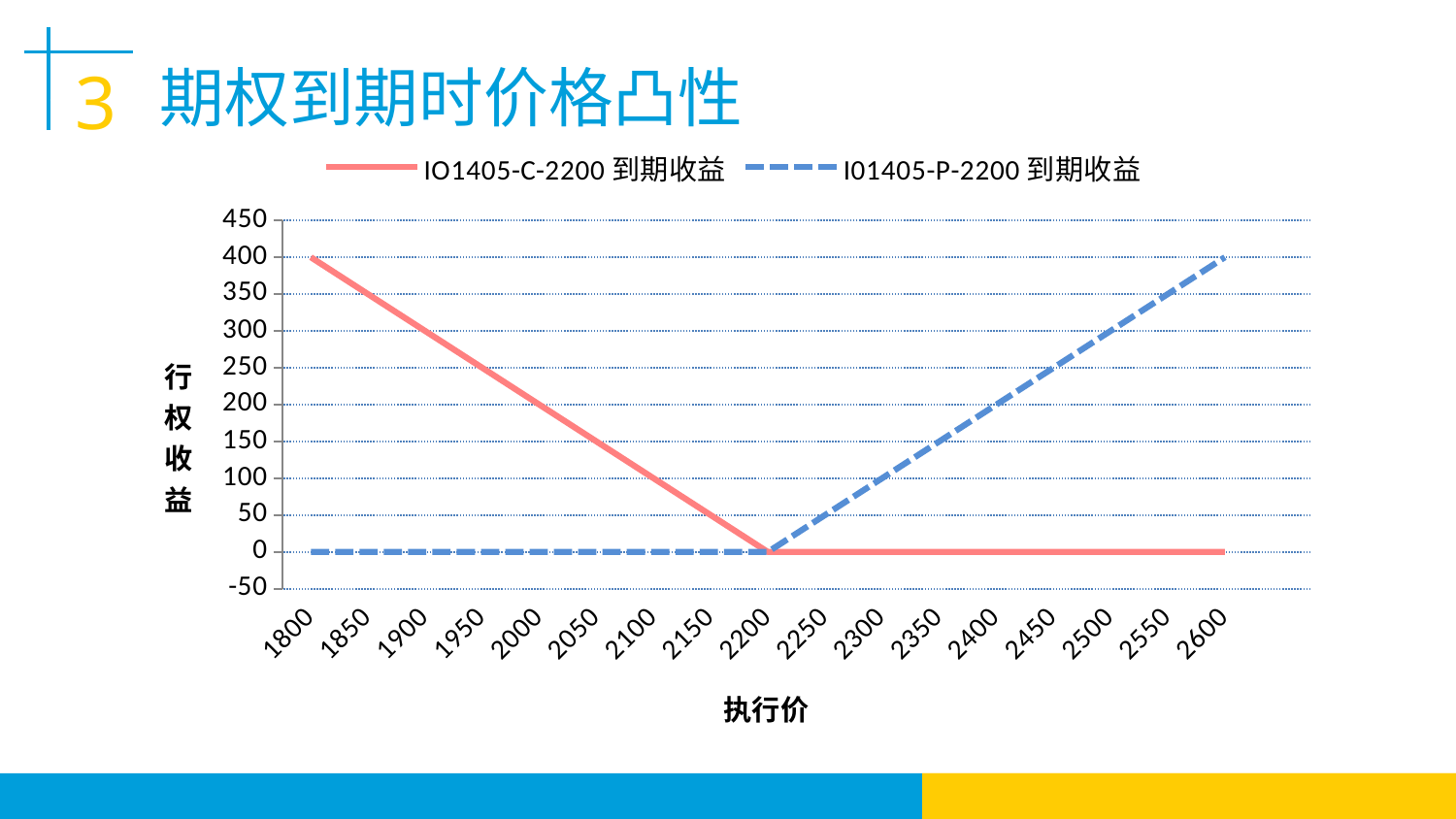
What is the title of the x axis? 执行价 Is the value of the IO1405-C-2200 到期收益 series at 执行价 1900 greater or less than 250? greater Does the IO1405-C-2200 到期收益 series rise or fall as 执行价 goes from 1800 to 2200? fall How many series does the legend list? 2 What is the value of the IO1405-C-2200 到期收益 series at 执行价 1800? 400 What is the value of the I01405-P-2200 到期收益 series at 执行价 2600? 400 How many 执行价 values are marked along the x axis? 17 What is the value of the IO1405-C-2200 到期收益 series at 执行价 2600? 0 At 执行价 1800, which series has the higher value? IO1405-C-2200 到期收益 What is the value of the I01405-P-2200 到期收益 series at 执行价 1800? 0 Does the I01405-P-2200 到期收益 series rise or fall as 执行价 goes from 2200 to 2600? rise What kind of chart is shown on the slide? line chart